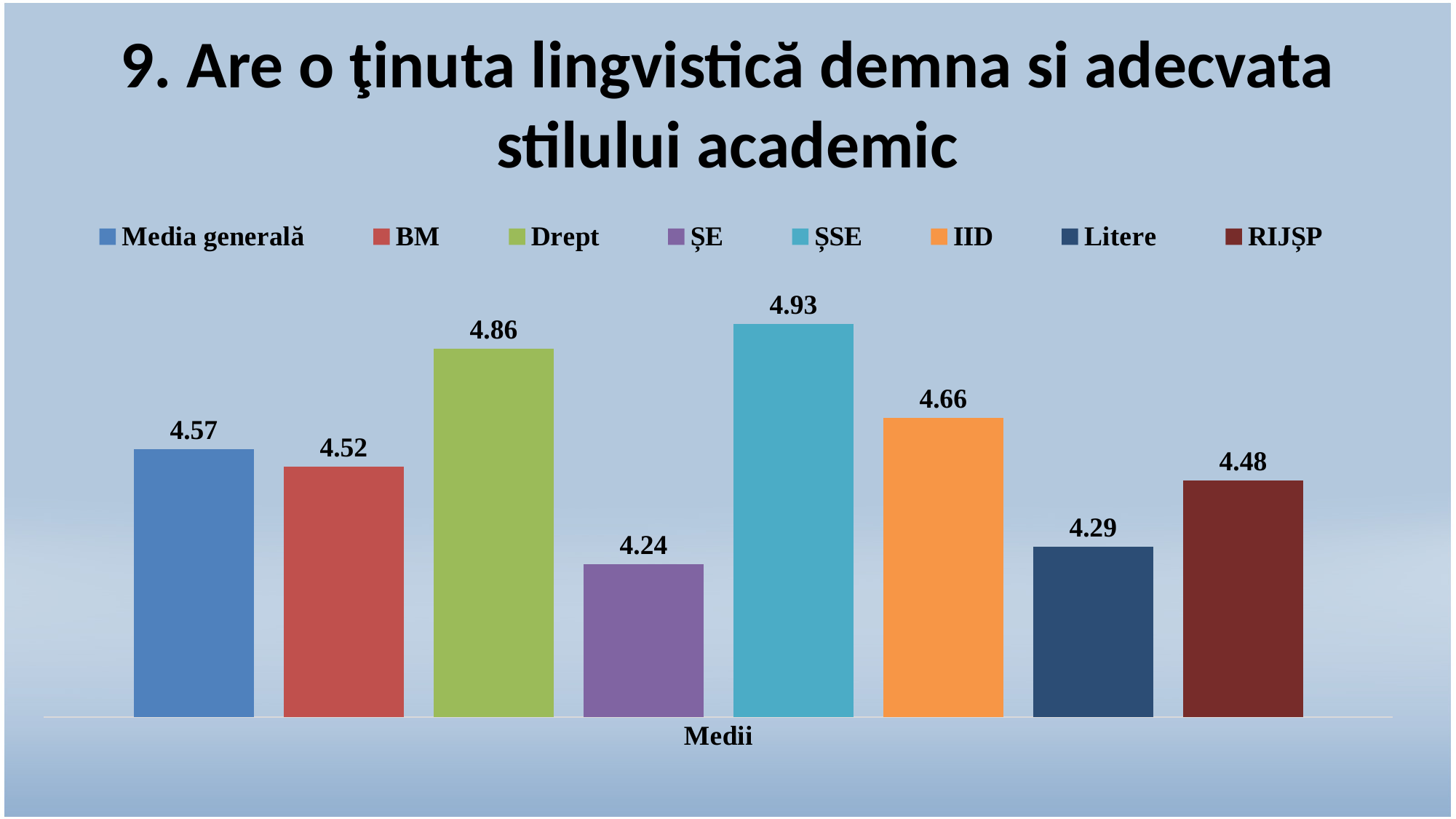
What is the label on the x axis? Medii How many series does the legend list? 8 Which series has the highest value? ȘSE What is the value for Media generală? 4.57 What is the difference between the values for Drept and ȘE? 0.62 What is the value for ȘSE? 4.93 What is the difference between the values for ȘSE and Litere? 0.64 What is the value for Litere? 4.29 Which series has the lowest value? ȘE What kind of chart is shown? bar chart What is the value for RIJȘP? 4.48 Which is larger, the value for IID or the value for BM? IID